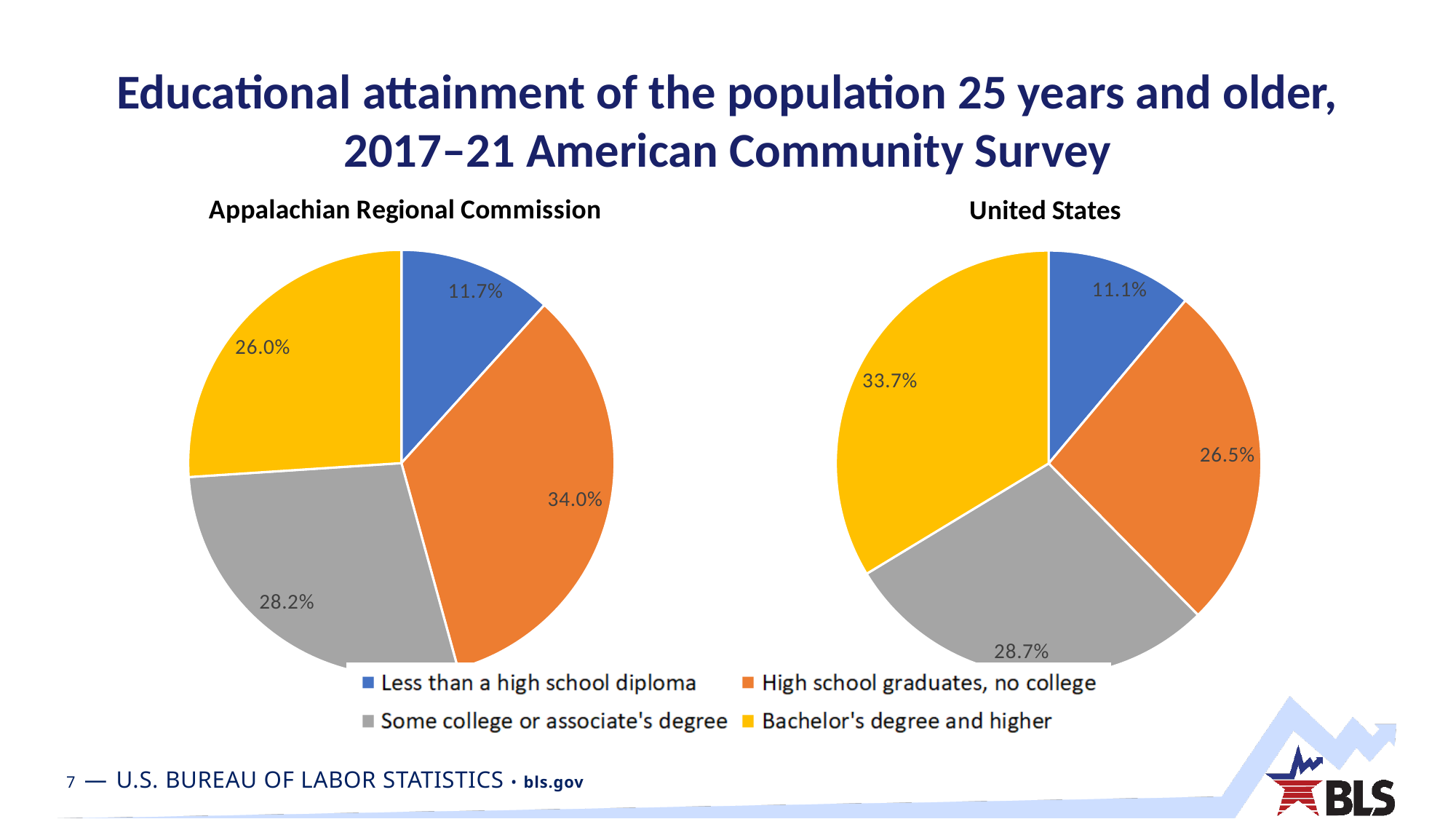
Which colour represents some college or associate's degree in the legend? Gray In the Appalachian Regional Commission pie chart, which category has the largest share? High school graduates, no college How many categories does each pie chart show? 4 In the Appalachian Regional Commission pie chart, what is the value for high school graduates, no college? 34.0% In the Appalachian Regional Commission pie chart, what share of the population has a bachelor's degree and higher? 26.0% In the United States pie chart, what share of the population has less than a high school diploma? 11.1% In the United States pie chart, which category has the smallest share? Less than a high school diploma What type of chart is used on this slide? Pie chart In the United States pie chart, which category has the largest share? Bachelor's degree and higher What is the difference between the bachelor's degree and higher share in the United States chart and in the Appalachian Regional Commission chart? 7.7 percentage points Which is larger: the high school graduates, no college share in the Appalachian Regional Commission chart or in the United States chart? Appalachian Regional Commission In the United States pie chart, what is the value for some college or associate's degree? 28.7%